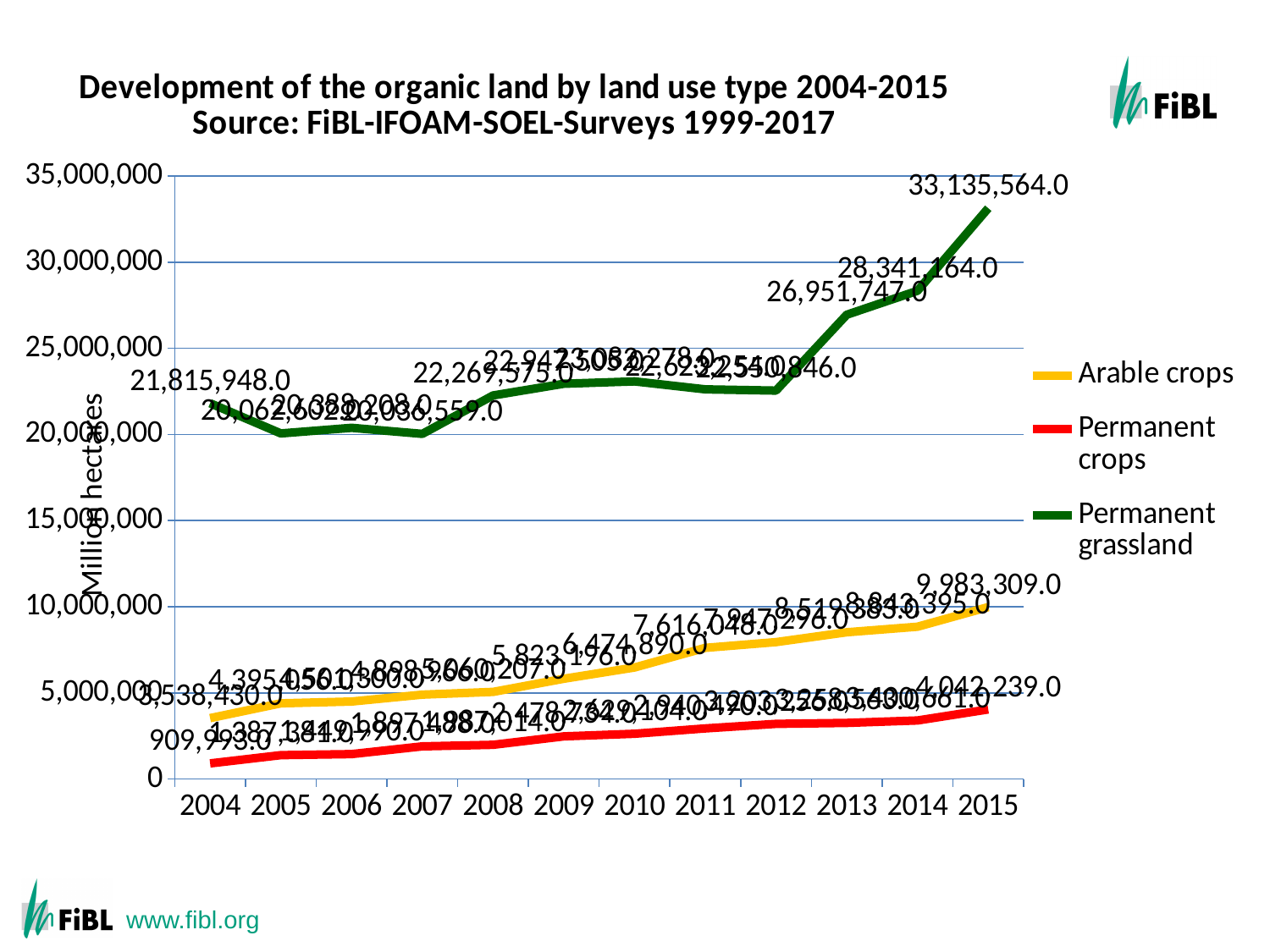
What is the value for Permanent grassland in 2015? 33,135,564.0 How many years are plotted along the x axis? 12 What is the value for Permanent crops in 2015? 4,042,239.0 What is the value for Permanent grassland in 2013? 26,951,747.0 In which year is Permanent grassland at its highest? 2015 What is the value for Arable crops in 2015? 9,983,309.0 What type of chart is shown on the slide? Line chart How many series does the legend list? 3 Do the values for Permanent crops rise or fall from 2004 to 2015? Rise In which year is Permanent crops at its lowest? 2004 Is the value for Permanent grassland in 2012 greater or less than 25,000,000? less What is the difference between the Permanent grassland values for 2015 and 2014? 4,794,400.0